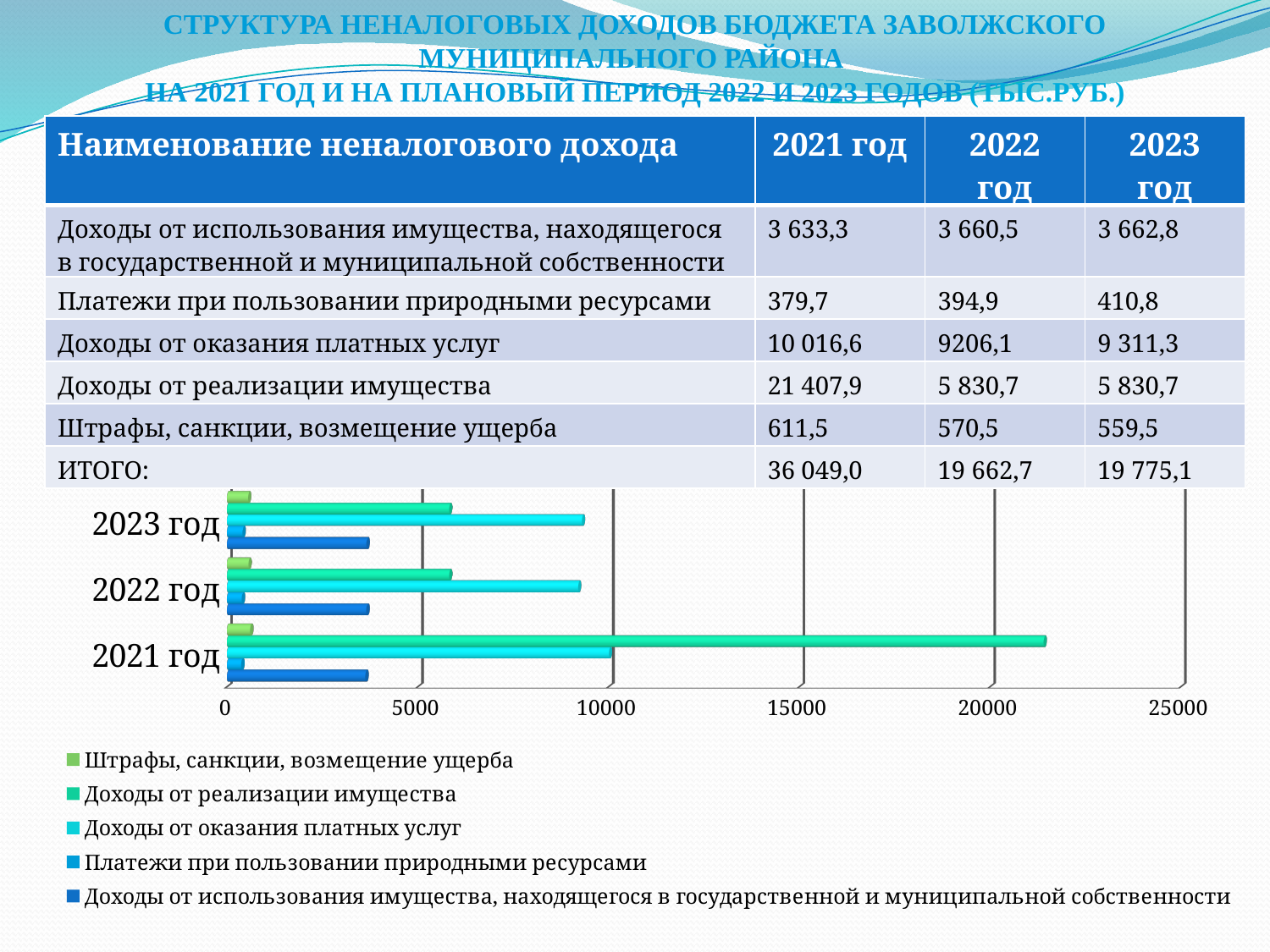
How many year categories does the chart show? 3 Is the value for Доходы от реализации имущества in 2021 greater or less than 20000? greater What is the value of Штрафы, санкции, возмещение ущерба for 2021 год? 611,5 In 2023, which is larger: Доходы от оказания платных услуг or Доходы от реализации имущества? Доходы от оказания платных услуг Do the values for Платежи при пользовании природными ресурсами rise or fall from 2021 to 2023? rise In which year is the bar for Доходы от реализации имущества the longest? 2021 год How many series does the chart legend list? 5 What is the value of Доходы от оказания платных услуг for 2023 год? 9 311,3 By how much does Доходы от реализации имущества in 2021 exceed the value in 2022? 15 577,2 What is the highest tick value shown on the chart's horizontal axis? 25000 Is the value for Доходы от оказания платных услуг in 2022 greater or less than 10000? less What type of chart is shown on the slide? bar chart